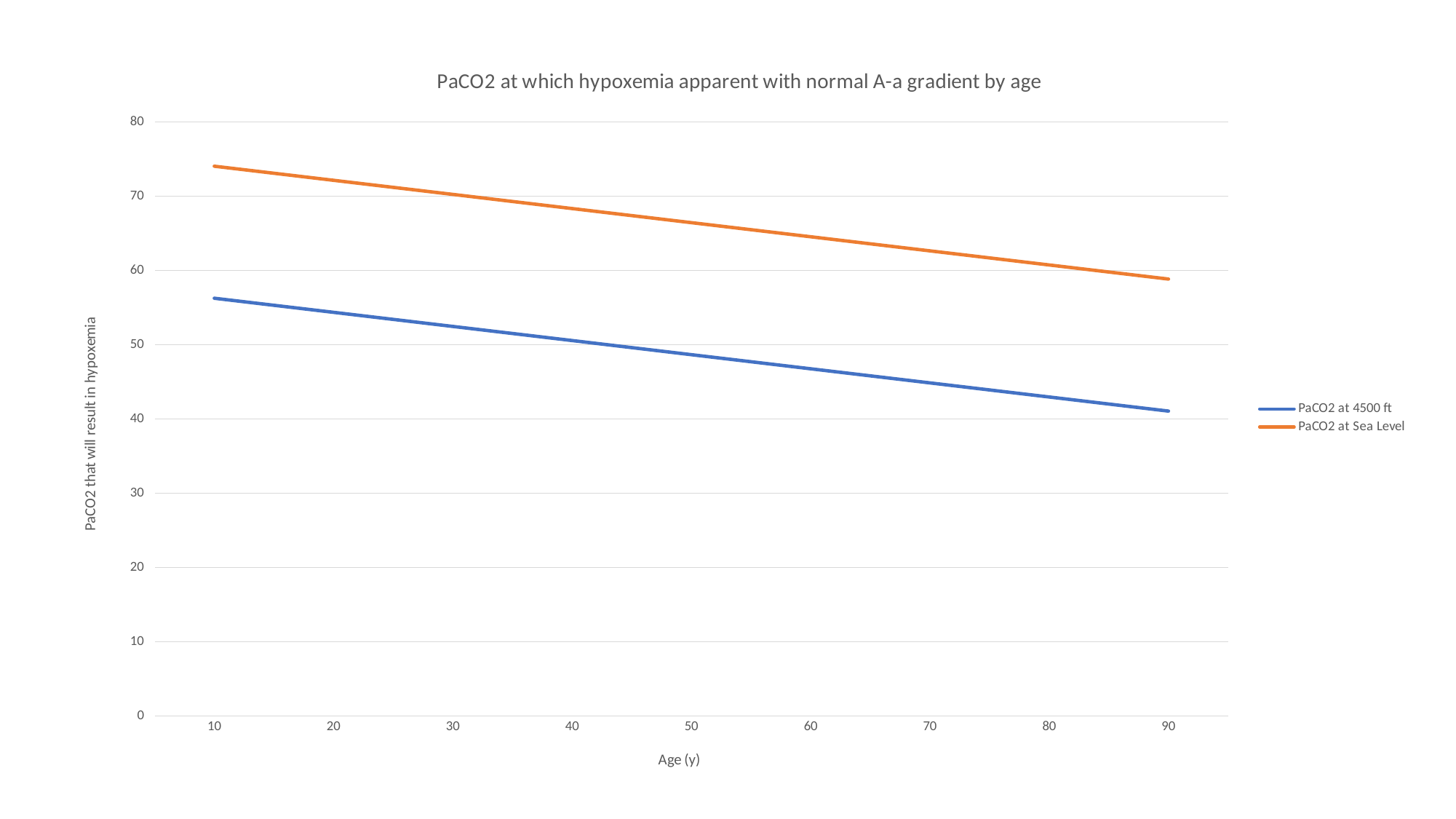
Do the values for PaCO2 at Sea Level rise or fall as age increases? fall Is the value for PaCO2 at 4500 ft at age 10 greater or less than 50? greater How many age values are marked along the x axis? 9 Is the value for PaCO2 at Sea Level at age 10 greater or less than 70? greater How many series does the legend list? 2 At age 50, which series has the higher value, PaCO2 at 4500 ft or PaCO2 at Sea Level? PaCO2 at Sea Level What is the title of the chart? PaCO2 at which hypoxemia apparent with normal A-a gradient by age What kind of chart is shown on the slide? line chart Is the value for PaCO2 at 4500 ft at age 90 greater or less than 50? less Do the values for PaCO2 at 4500 ft rise or fall as age increases? fall What is the label on the x axis? Age (y)